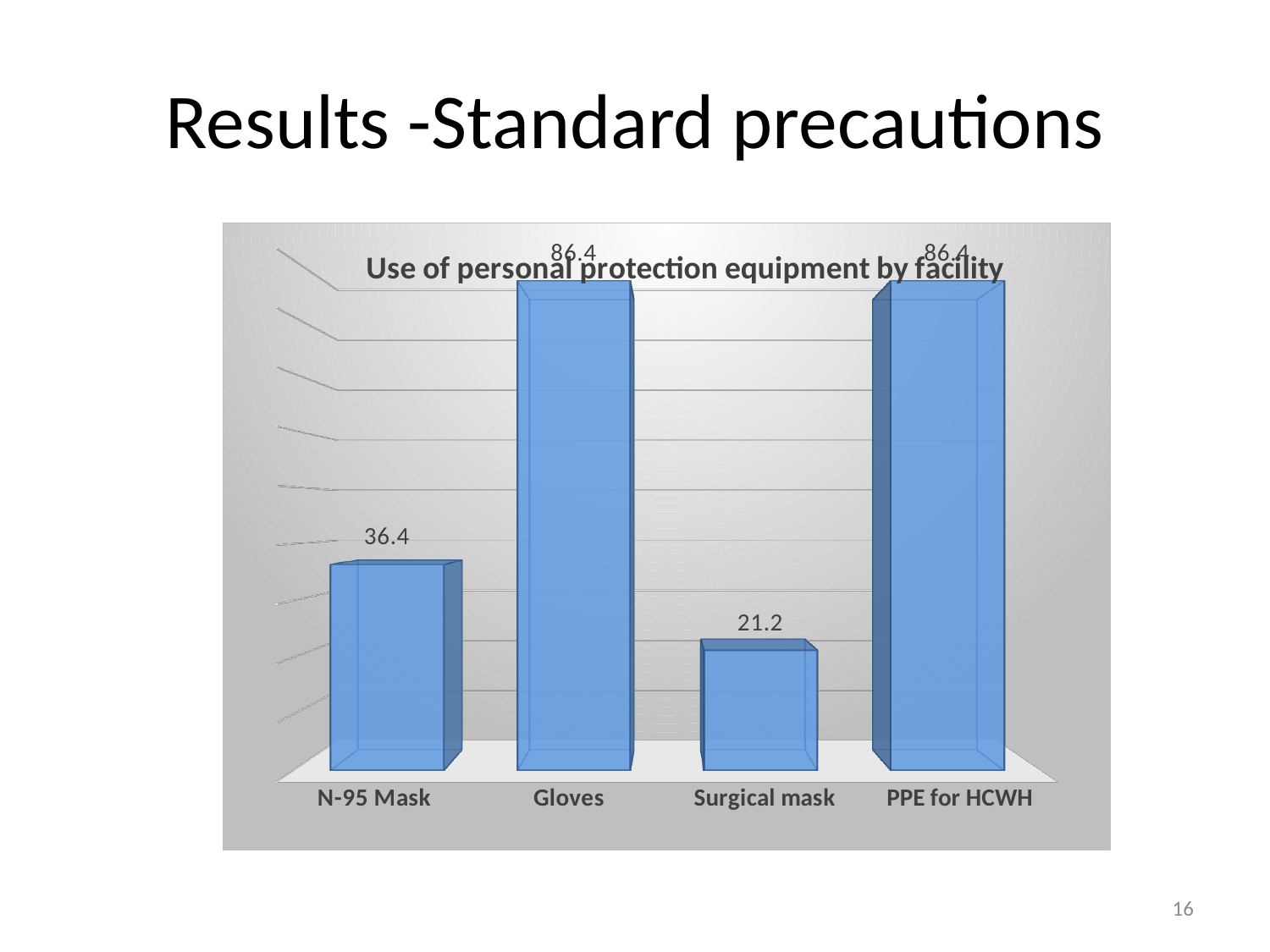
Which is larger, the value for N-95 Mask or the value for Surgical mask? N-95 Mask What is the value for Gloves? 86.4 What is the value for PPE for HCWH? 86.4 How many categories are shown in the chart? 4 Which category has the lowest value? Surgical mask What is the highest value shown in the chart? 86.4 What is the title of the chart? Use of personal protection equipment by facility What kind of chart is shown on the slide? Bar chart What is the value for Surgical mask? 21.2 What is the value for N-95 Mask? 36.4 What is the difference between the values for N-95 Mask and Surgical mask? 15.2 What is the difference between the values for Gloves and N-95 Mask? 50